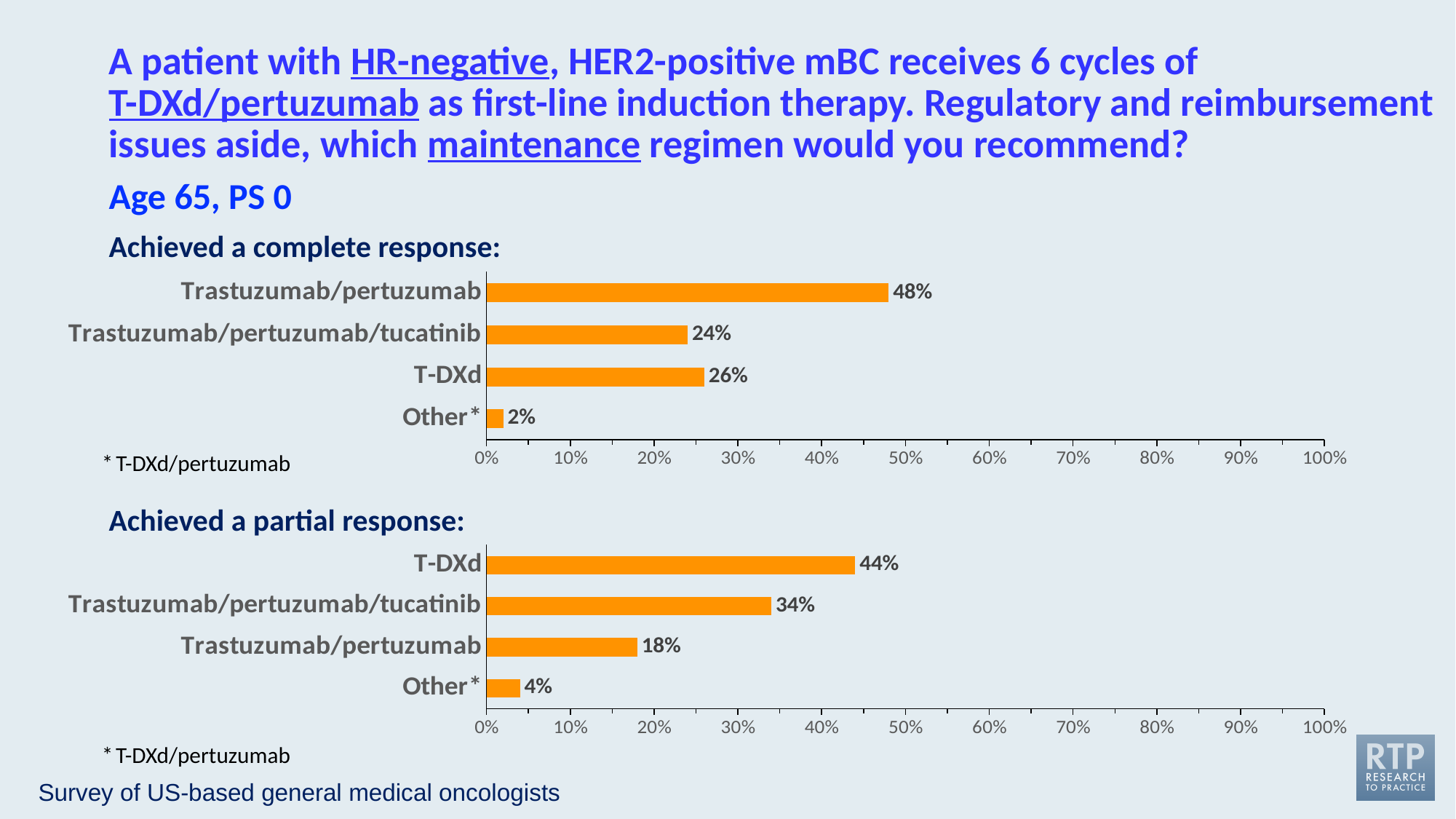
What type of chart is used for the 'Achieved a complete response' data? Bar chart In the 'Achieved a partial response' chart, which regimen has the lowest value? Other* In the 'Achieved a partial response' chart, is the value for T-DXd greater or less than 40%? greater In the 'Achieved a complete response' chart, what is the value for T-DXd? 26% In the 'Achieved a partial response' chart, what is the difference between T-DXd and Trastuzumab/pertuzumab? 26% How many categories are shown in the 'Achieved a partial response' chart? 4 In the 'Achieved a partial response' chart, what is the value for Other*? 4% In the 'Achieved a complete response' chart, what percentage of respondents chose Trastuzumab/pertuzumab? 48% In the 'Achieved a complete response' chart, what is the difference between Trastuzumab/pertuzumab and Trastuzumab/pertuzumab/tucatinib? 24% In the 'Achieved a partial response' chart, what percentage chose Trastuzumab/pertuzumab/tucatinib? 34% In the 'Achieved a complete response' chart, which is larger: T-DXd or Trastuzumab/pertuzumab/tucatinib? T-DXd In the 'Achieved a complete response' chart, which regimen has the highest value? Trastuzumab/pertuzumab